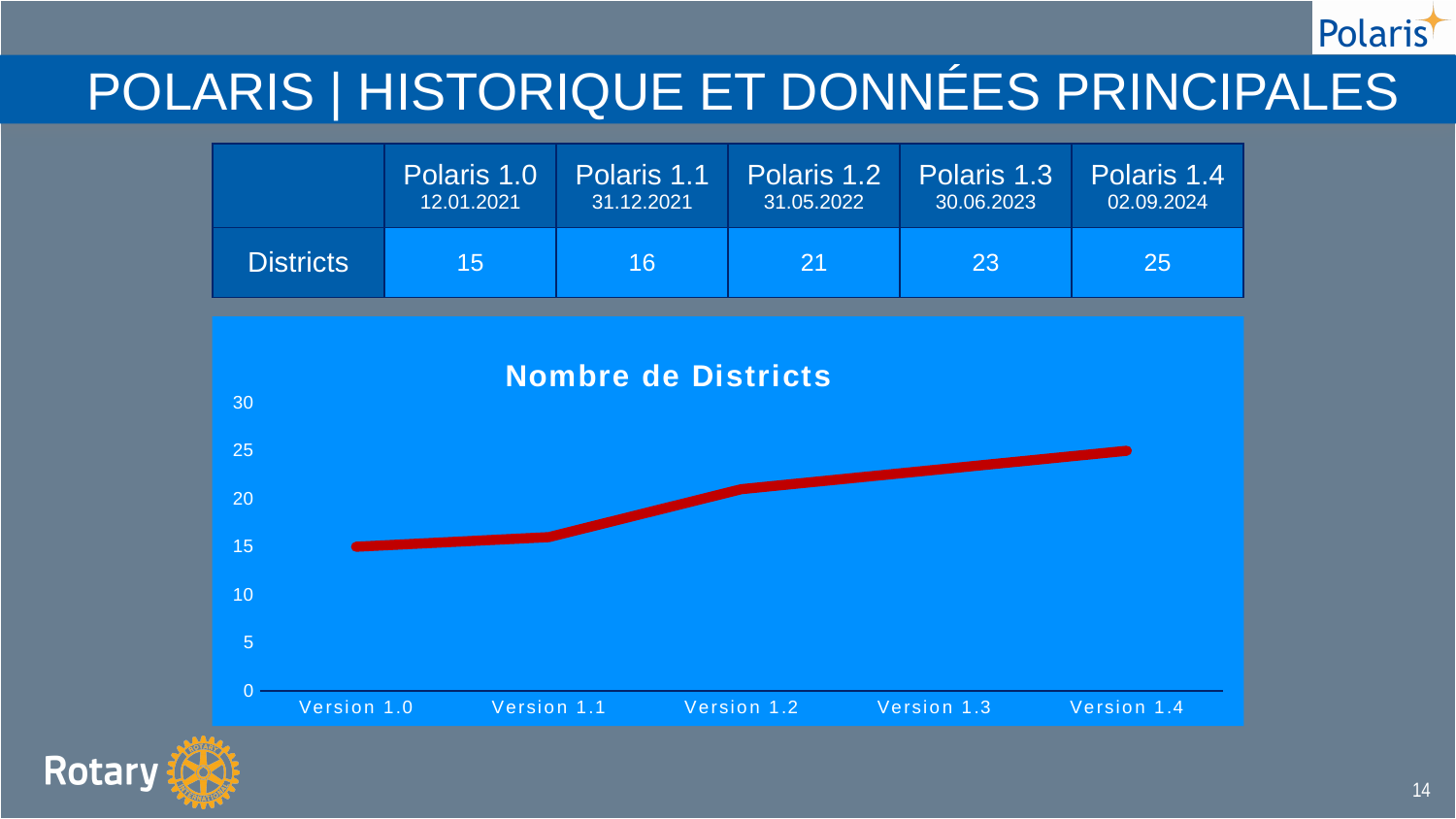
How many versions are plotted along the x axis of the chart? 5 Does the number of districts rise or fall from Version 1.0 to Version 1.4? rise Which version has the lowest number of districts in the chart? Version 1.0 What is the number of districts for Version 1.4 in the chart? 25 Which version has the highest number of districts in the chart? Version 1.4 Is the value for Version 1.1 greater or less than 20? less Is the value for Version 1.2 greater or less than 20? greater What is the title of the chart? Nombre de Districts What is the number of districts for Version 1.0 in the chart? 15 What is the difference in the number of districts between Version 1.4 and Version 1.0? 10 What kind of chart is shown on the slide? line chart Is the value for Version 1.3 greater or less than 25? less